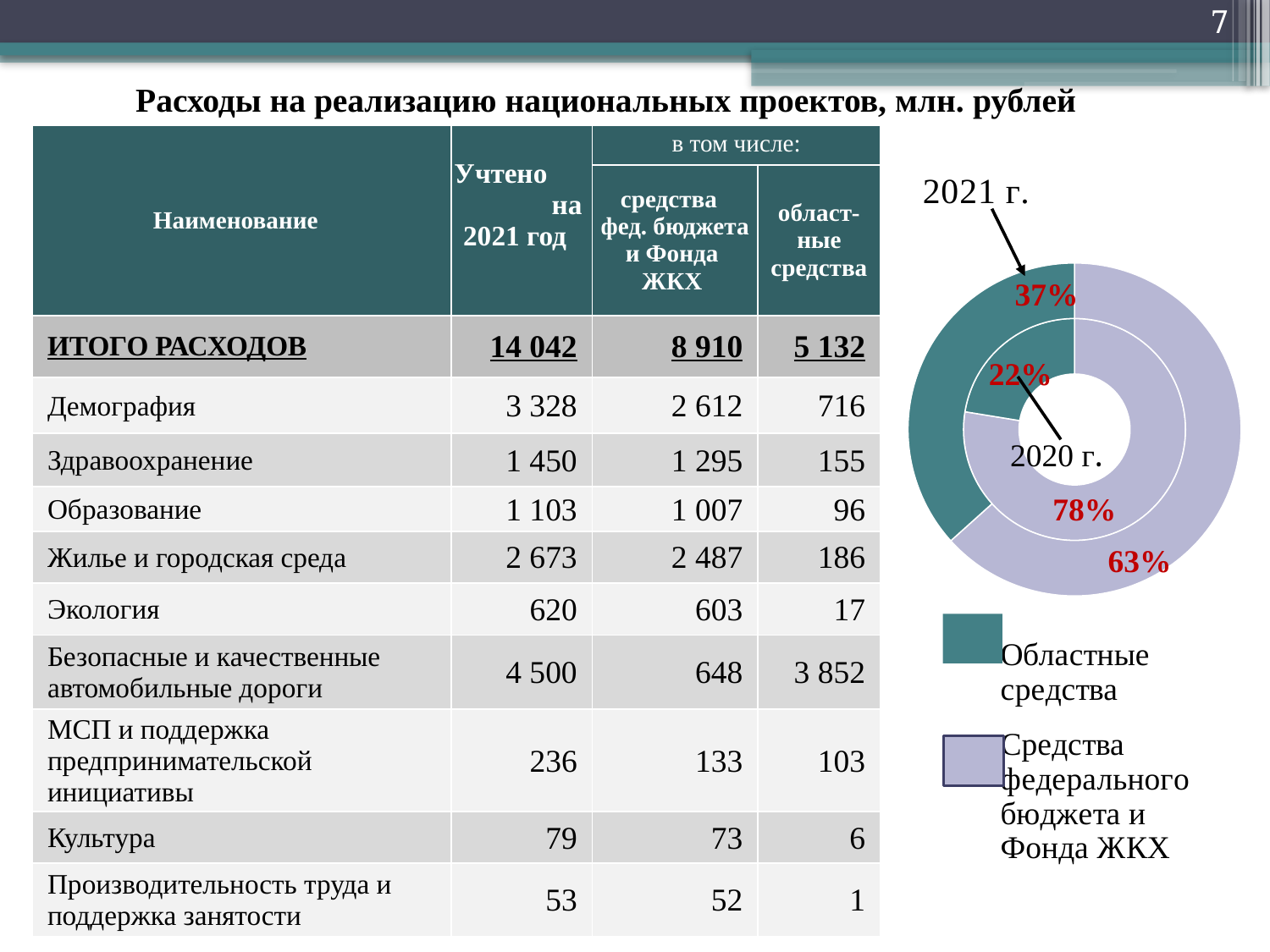
In the doughnut chart, what share do Областные средства have in 2021? 37% In the doughnut chart, is the share of Областные средства larger in 2020 or in 2021? 2021 How many years (rings) does the doughnut chart show? 2 In the doughnut chart, which category has the smaller share in 2020? Областные средства In the doughnut chart, by how many percentage points did the share of Областные средства change from 2020 to 2021? 15 percentage points In the doughnut chart, what share do Областные средства have in 2020? 22% In the doughnut chart, what share do Средства федерального бюджета и Фонда ЖКХ have in 2021? 63% In the doughnut chart, which colour represents Областные средства? Teal (dark green) How many categories does the legend of the doughnut chart list? 2 In the doughnut chart, which category has the larger share in 2021? Средства федерального бюджета и Фонда ЖКХ What kind of chart is shown on the right of the slide? Doughnut chart